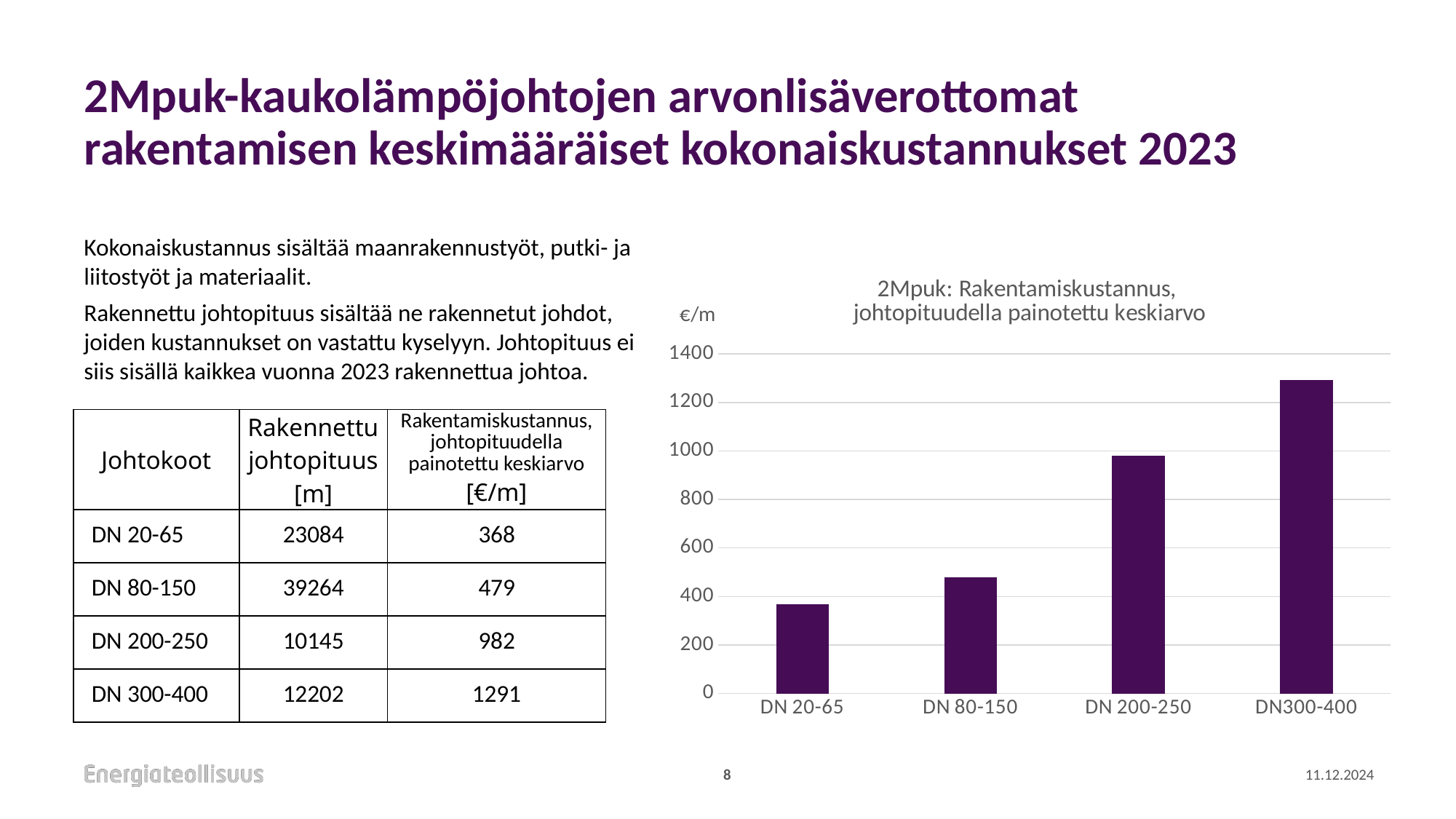
How many categories are plotted on the x axis of the chart? 4 What kind of chart is shown on the slide? bar chart What is the title of the chart? 2Mpuk: Rakentamiskustannus, johtopituudella painotettu keskiarvo Which category has the highest bar in the chart? DN300-400 Is the value for DN 200-250 greater or less than 800? greater Which is larger, the value for DN 80-150 or the value for DN 200-250? DN 200-250 Is the value for DN300-400 greater or less than 1200? greater Do the values rise or fall from left to right along the x axis? rise Is the value for DN 80-150 greater or less than 600? less What unit is shown at the top of the chart's vertical axis? €/m According to the table on the slide, what is the construction cost (€/m) for DN 300-400? 1291 Which category has the lowest bar in the chart? DN 20-65